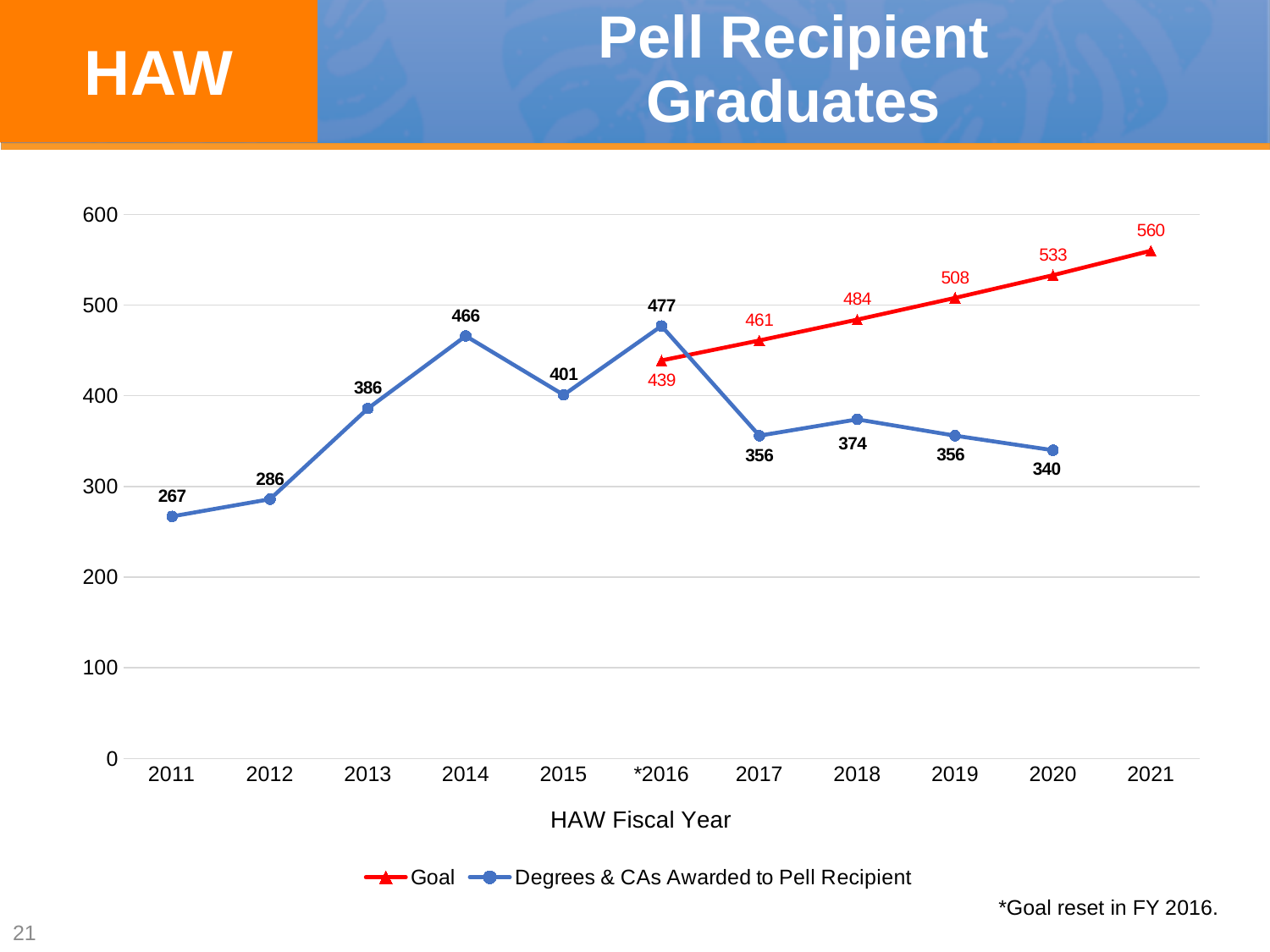
What is the difference between the Goal and the Degrees & CAs Awarded to Pell Recipient in 2020? 193 What is the x-axis title of the chart? HAW Fiscal Year How many years are shown on the x axis? 11 In which year is the Degrees & CAs Awarded to Pell Recipient value highest? *2016 What is the value of Degrees & CAs Awarded to Pell Recipient in 2014? 466 What is the Goal value for 2021? 560 How many series does the legend list? 2 What is the Goal value for *2016? 439 In which year is the Degrees & CAs Awarded to Pell Recipient value lowest? 2011 Does the Goal series rise or fall from *2016 to 2021? Rise What kind of chart is shown on the slide? Line chart Which is larger in 2017, the Goal or the Degrees & CAs Awarded to Pell Recipient? Goal